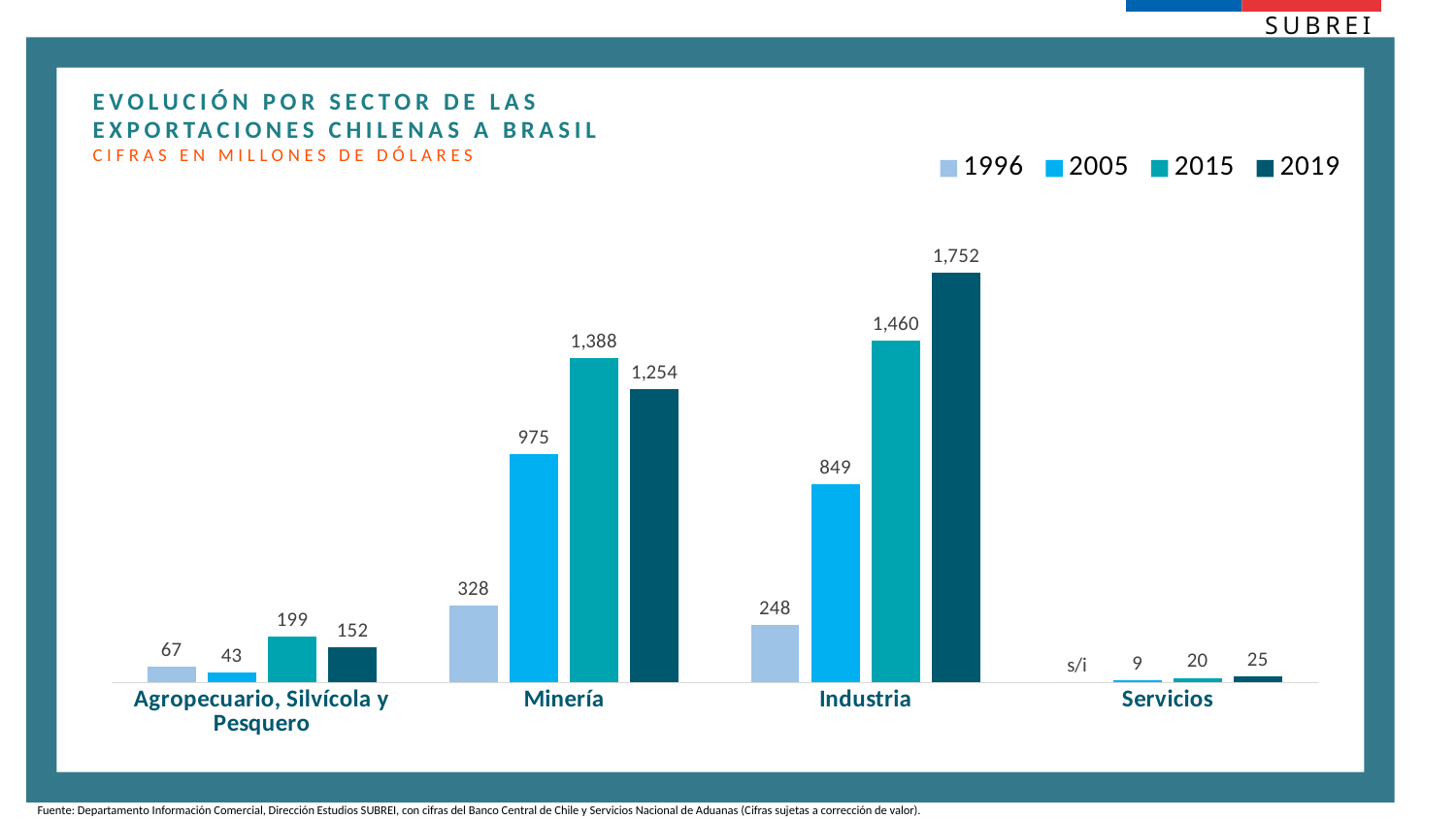
Which is larger: Industria in 2005 or Minería in 2005? Minería in 2005 Which sector had the lowest export value in 2015? Servicios What kind of chart is shown on the slide? Bar chart Which sector had the highest export value in 2019? Industria How many sectors are shown on the x axis? 4 What was the value for Minería in 2005? 975 How many series does the legend list? 4 What is shown for Servicios in 1996? s/i What was the value of Chilean exports to Brazil in the Industria sector in 2019? 1,752 What was the value for Agropecuario, Silvícola y Pesquero in 1996? 67 Do the values for Industria rise or fall from 1996 to 2019? Rise What is the difference between the Minería values for 2015 and 2019? 134